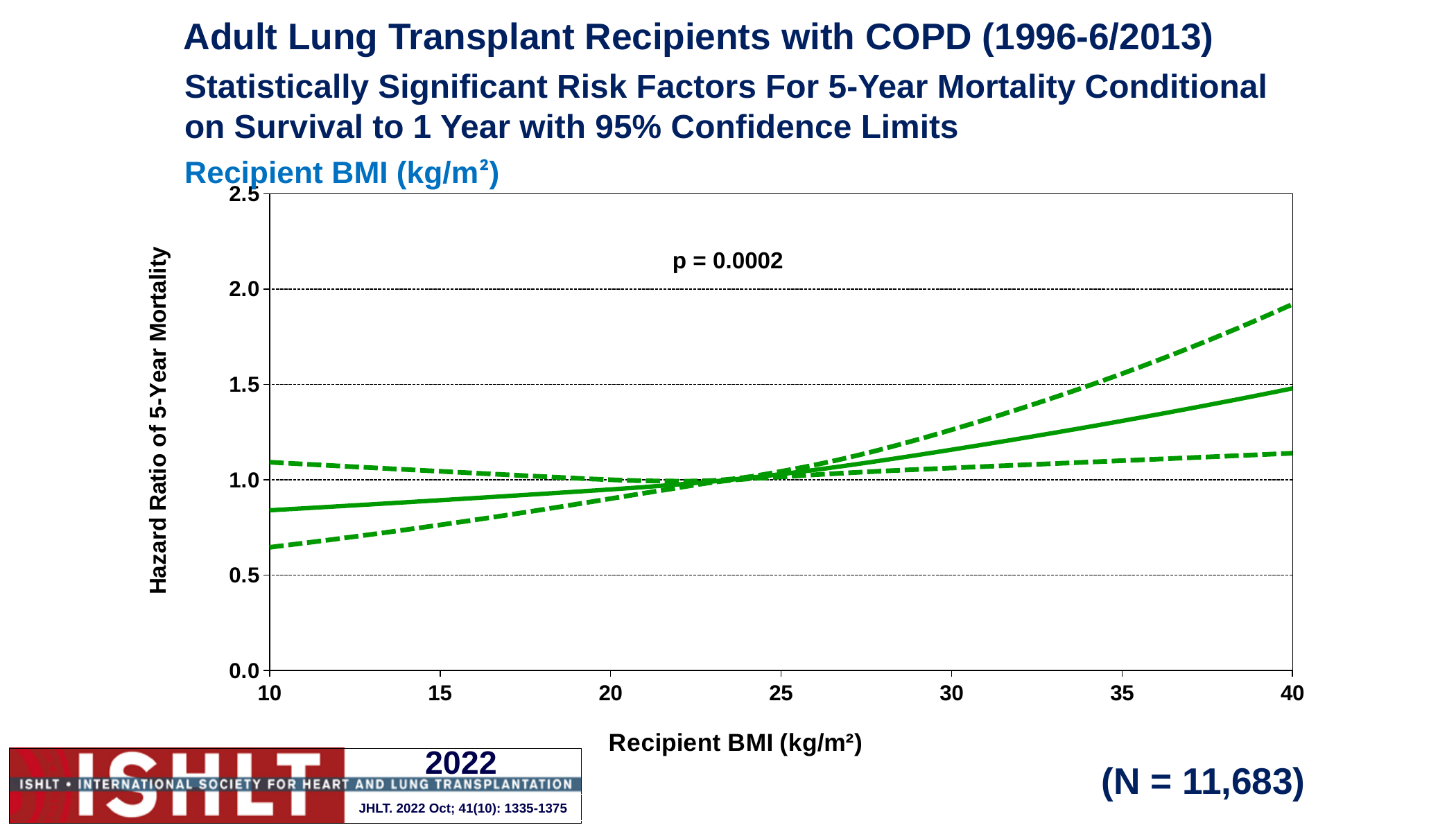
Does the solid hazard ratio line rise or fall as Recipient BMI increases from 10 to 40? rise At which Recipient BMI value on the x axis is the solid hazard ratio line lowest? 10 How many lines are plotted on the chart? 3 What p-value is printed on the chart? p = 0.0002 Is the lower 95% confidence limit (lower dashed line) at a Recipient BMI of 40 greater or less than 1.0? greater What kind of chart is shown on the slide? line chart Is the upper 95% confidence limit (upper dashed line) at a Recipient BMI of 40 greater or less than 2.0? less At which Recipient BMI value on the x axis is the solid hazard ratio line highest? 40 Is the hazard ratio (solid line) at a Recipient BMI of 10 greater or less than 1.0? less What is the label of the y axis? Hazard Ratio of 5-Year Mortality